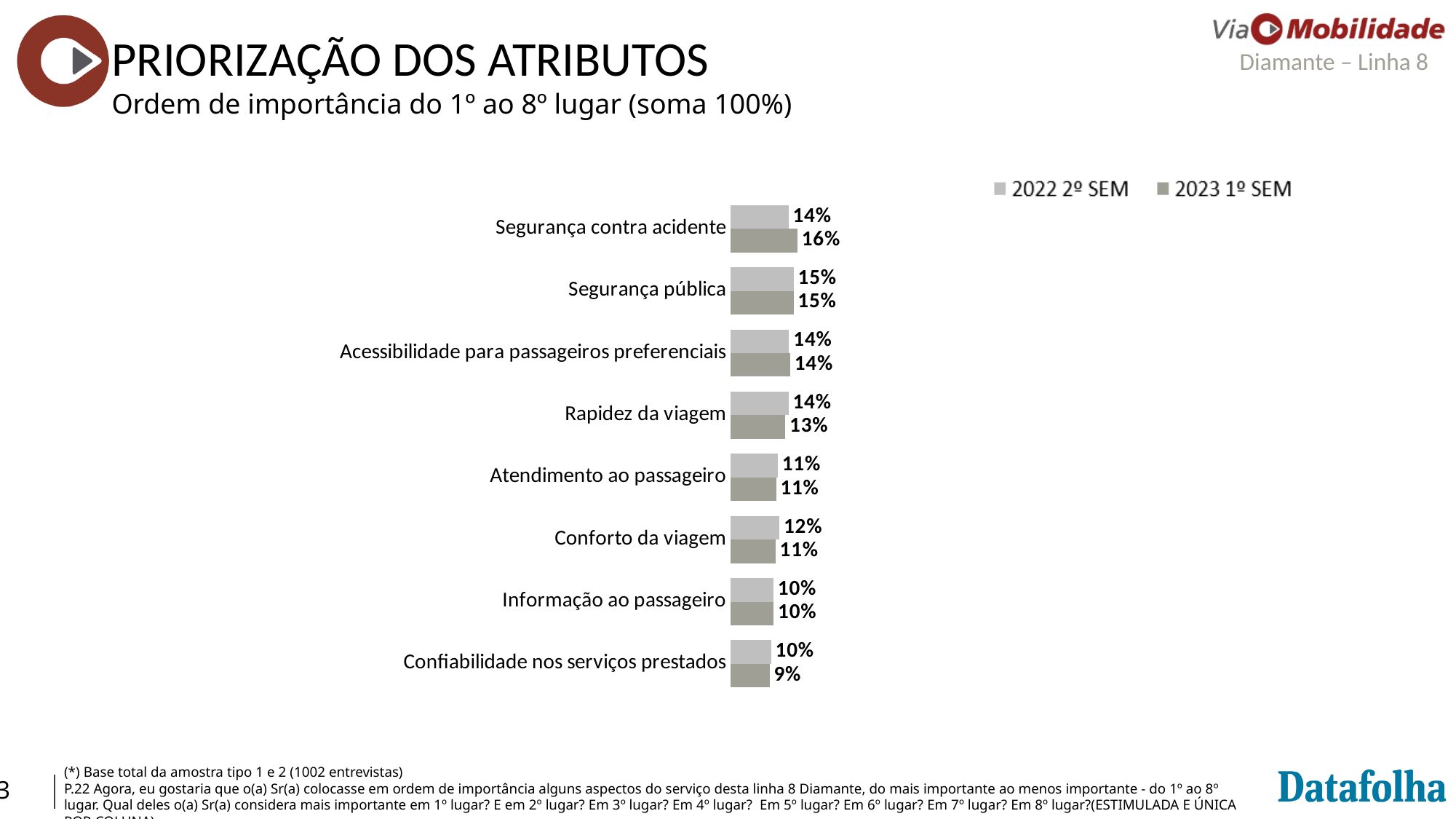
What is the value for Atendimento ao passageiro in the 2022 2º SEM series? 11% What is the value for Segurança contra acidente in the 2023 1º SEM series? 16% What kind of chart is shown on the slide? Bar chart What is the value for Rapidez da viagem in the 2022 2º SEM series? 14% How many categories are shown in the chart? 8 What is the difference between the 2023 1º SEM and 2022 2º SEM values for Segurança contra acidente? 2% What is the value for Confiabilidade nos serviços prestados in the 2023 1º SEM series? 9% Which category has the highest value in the 2023 1º SEM series? Segurança contra acidente Which is larger for Conforto da viagem: the 2022 2º SEM value or the 2023 1º SEM value? 2022 2º SEM What are the two series listed in the chart legend? 2022 2º SEM and 2023 1º SEM How many series does the legend list? 2 Which category has the lowest value in the 2023 1º SEM series? Confiabilidade nos serviços prestados